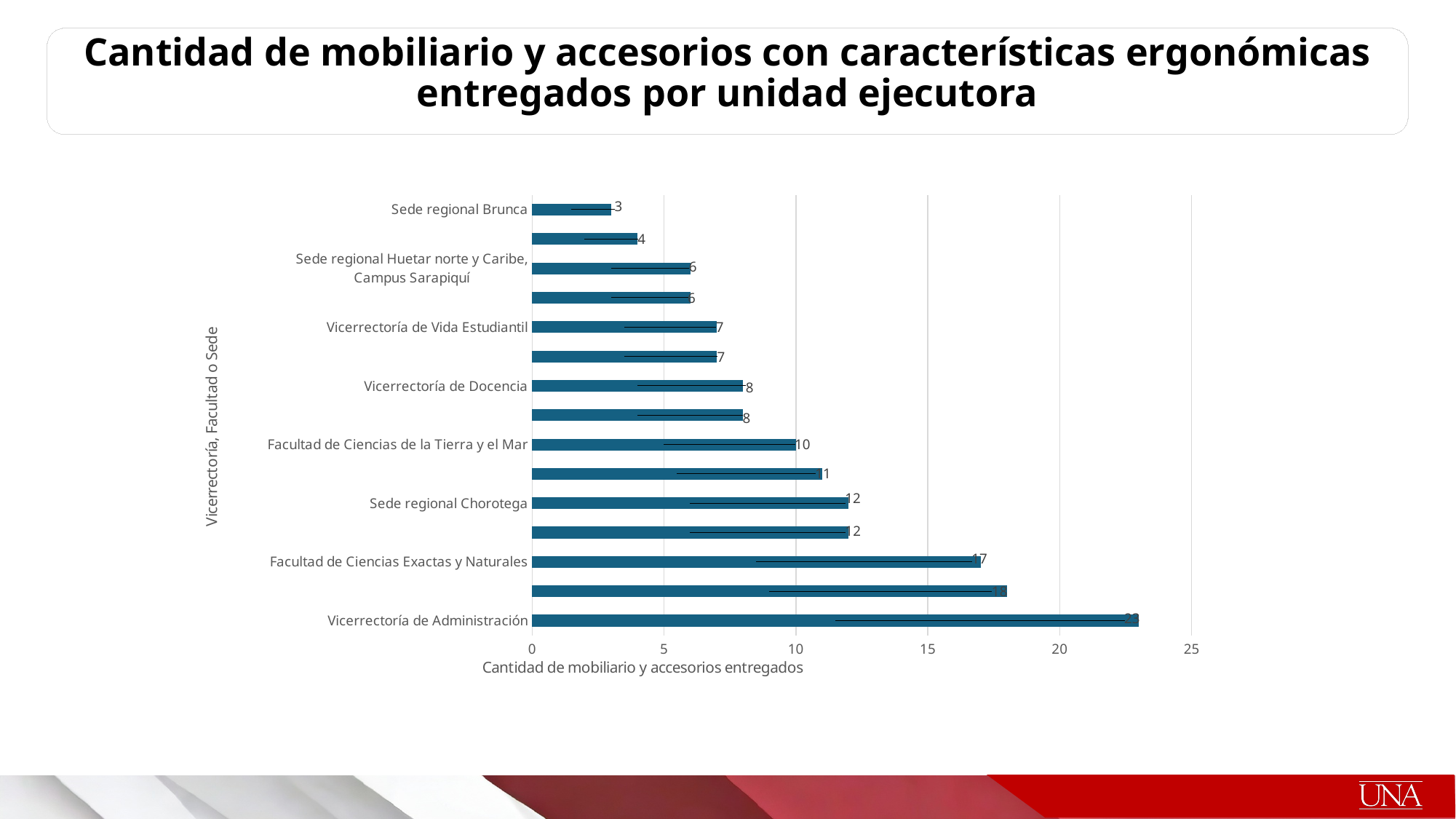
What is the value for Vicerrectoría de Docencia? 8 Is the value for Vicerrectoría de Administración greater or less than 20? greater What is the value for Facultad de Ciencias Exactas y Naturales? 17 What is the value for Vicerrectoría de Vida Estudiantil? 7 What is the difference between the values for Facultad de Ciencias Exactas y Naturales and Sede regional Chorotega? 5 What is the value for Sede regional Huetar norte y Caribe, Campus Sarapiquí? 6 Which labeled unit has the lowest number of items delivered? Sede regional Brunca Which labeled unit has the highest number of items delivered? Vicerrectoría de Administración What kind of chart is shown on the slide? bar chart What is the value for Facultad de Ciencias de la Tierra y el Mar? 10 How many items were delivered to Sede regional Brunca? 3 What is the title of the horizontal axis? Cantidad de mobiliario y accesorios entregados